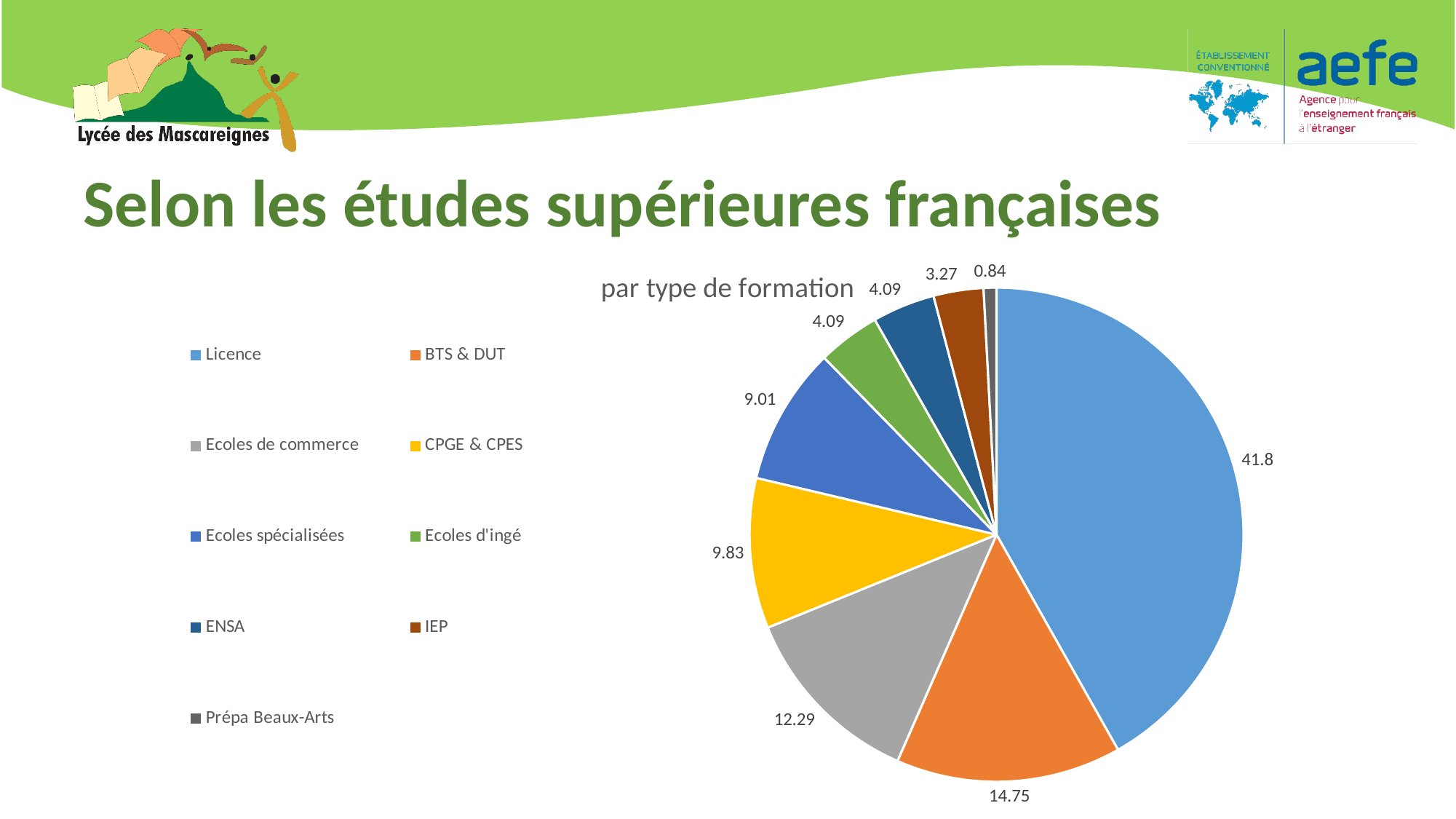
What is the difference between the values for Licence and BTS & DUT? 27.05 What is the value shown for CPGE & CPES in the pie chart? 9.83 What is the value shown for Ecoles de commerce in the pie chart? 12.29 What is the value shown for IEP in the pie chart? 3.27 What kind of chart is shown on the slide? Pie chart Which category has the largest slice of the pie chart? Licence How many categories does the legend of the pie chart list? 9 What is the title of the chart? par type de formation Which category has the smallest slice of the pie chart? Prépa Beaux-Arts What is the value shown for Licence in the pie chart? 41.8 Which is larger, the value for Ecoles de commerce or the value for Ecoles spécialisées? Ecoles de commerce What is the value shown for BTS & DUT in the pie chart? 14.75